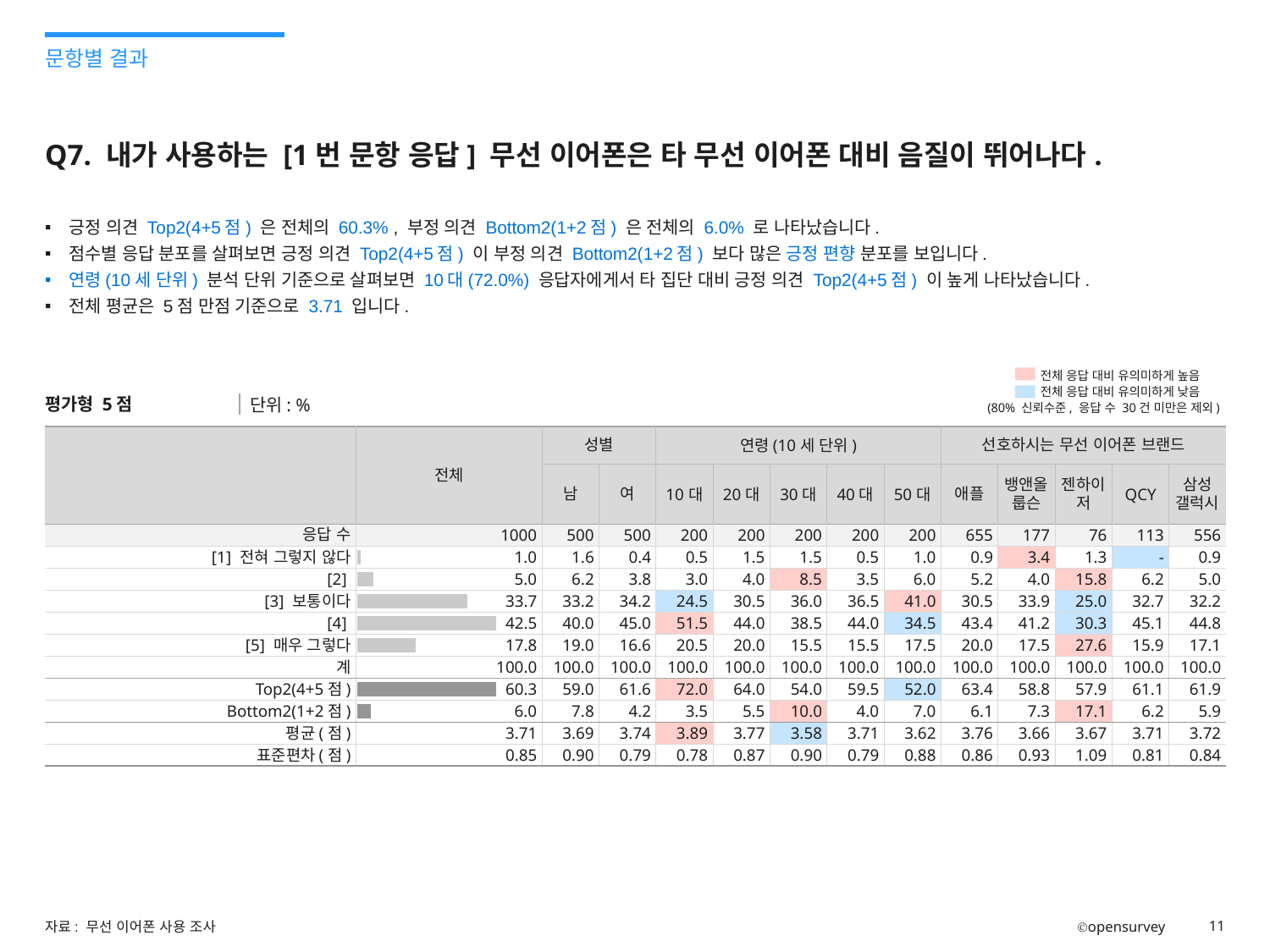
In the 전체 bar chart, what is the difference between Top2(4+5점) and Bottom2(1+2점)? 54.3 In the bar chart in the 전체 column, what is the value for Top2(4+5점)? 60.3 How many bars are drawn in the 전체 column bar chart? 7 In the bar chart in the 전체 column, what is the value for [3] 보통이다? 33.7 What unit do the values in the 전체 bar chart use, according to the slide? % In the 전체 bar chart, what is the difference between [4] and [3] 보통이다? 8.8 Among the five score categories [1] to [5] in the 전체 bar chart, which has the shortest bar? [1] 전혀 그렇지 않다 In the 전체 bar chart, which is larger: [3] 보통이다 or [5] 매우 그렇다? [3] 보통이다 What kind of chart is shown in the 전체 column of the table? Bar chart Among the five score categories [1] to [5] in the 전체 bar chart, which has the longest bar? [4] In the bar chart in the 전체 column, what is the value for [4]? 42.5 In the bar chart in the 전체 column, what is the value for [5] 매우 그렇다? 17.8